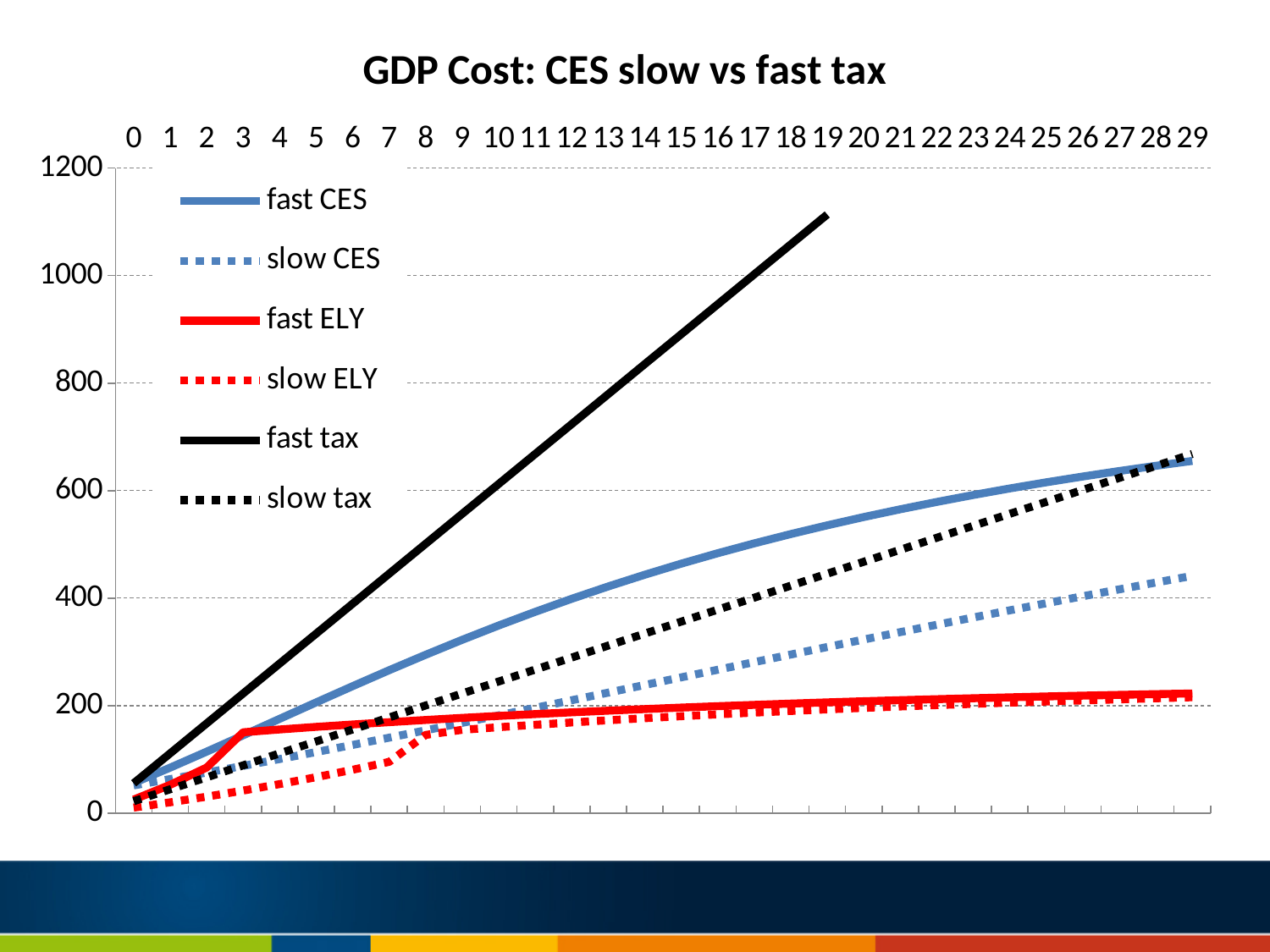
Is the value for slow CES at x = 29 greater or less than 400? greater Is the value for fast ELY at x = 29 greater or less than 400? less At x = 29, which is larger, fast CES or slow CES? fast CES Which series is drawn as a solid black line? fast tax Is the value for fast CES at x = 29 greater or less than 600? greater Which series reaches the highest value on the chart? fast tax What is the title of the chart? GDP Cost: CES slow vs fast tax How many series does the legend list? 6 Does the fast CES series rise or fall as x increases from 0 to 29? rise How many points are labelled along the x axis? 30 What kind of chart is shown on the slide? line chart